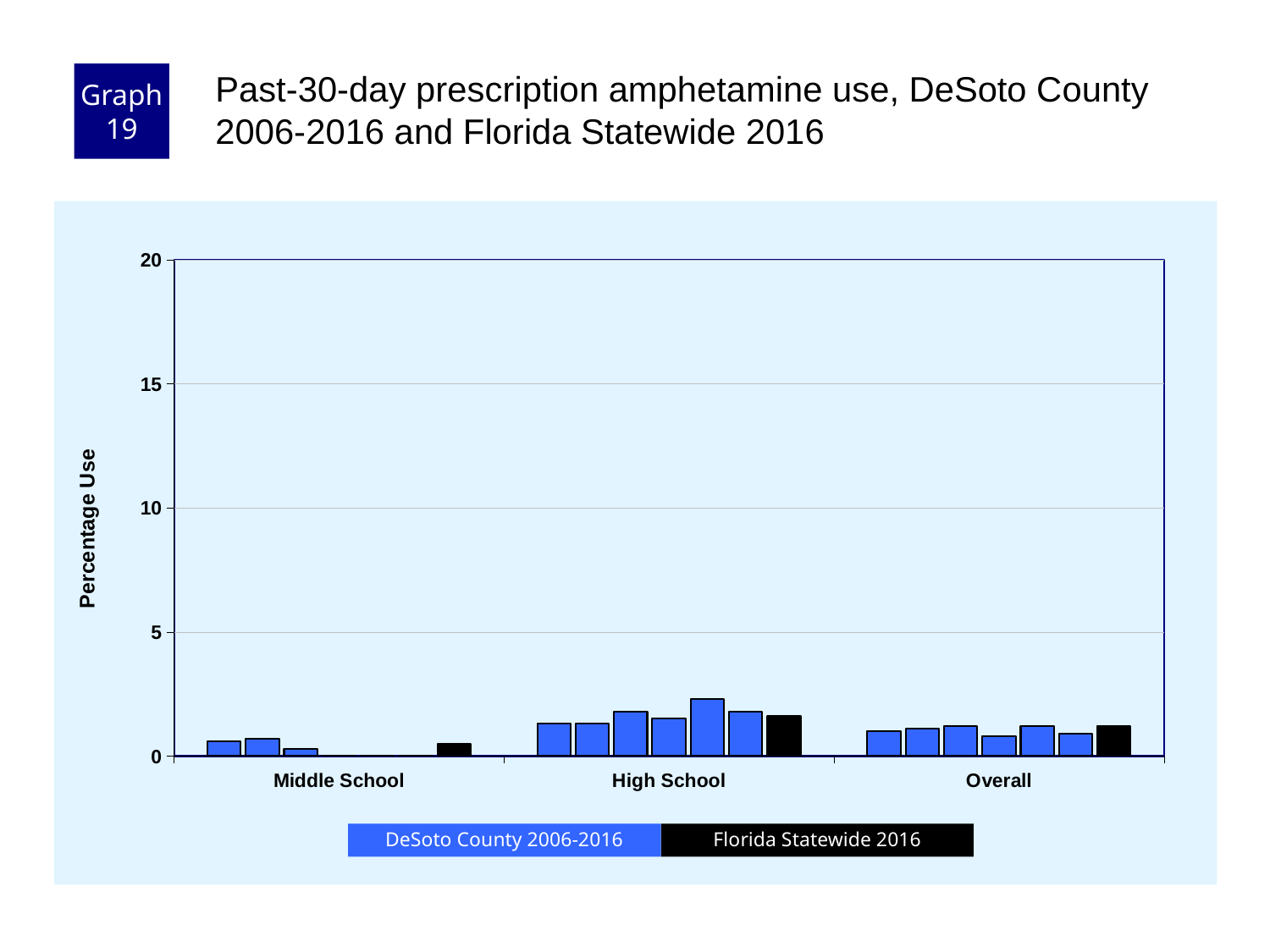
Is the Florida Statewide 2016 value for High School greater or less than 5? less What colour are the Florida Statewide 2016 bars? black Is the Florida Statewide 2016 value for Middle School greater or less than 5? less How many categories are shown on the x axis? 3 Which is larger, the Florida Statewide 2016 value for High School or for Middle School? High School Are any of the bars in the chart greater than 5? No Which category has the tallest bar in the chart? High School What is the label on the y axis? Percentage Use Which is larger, the Florida Statewide 2016 value for Overall or for Middle School? Overall How many series does the legend list? 2 What kind of chart is shown on the slide? bar chart